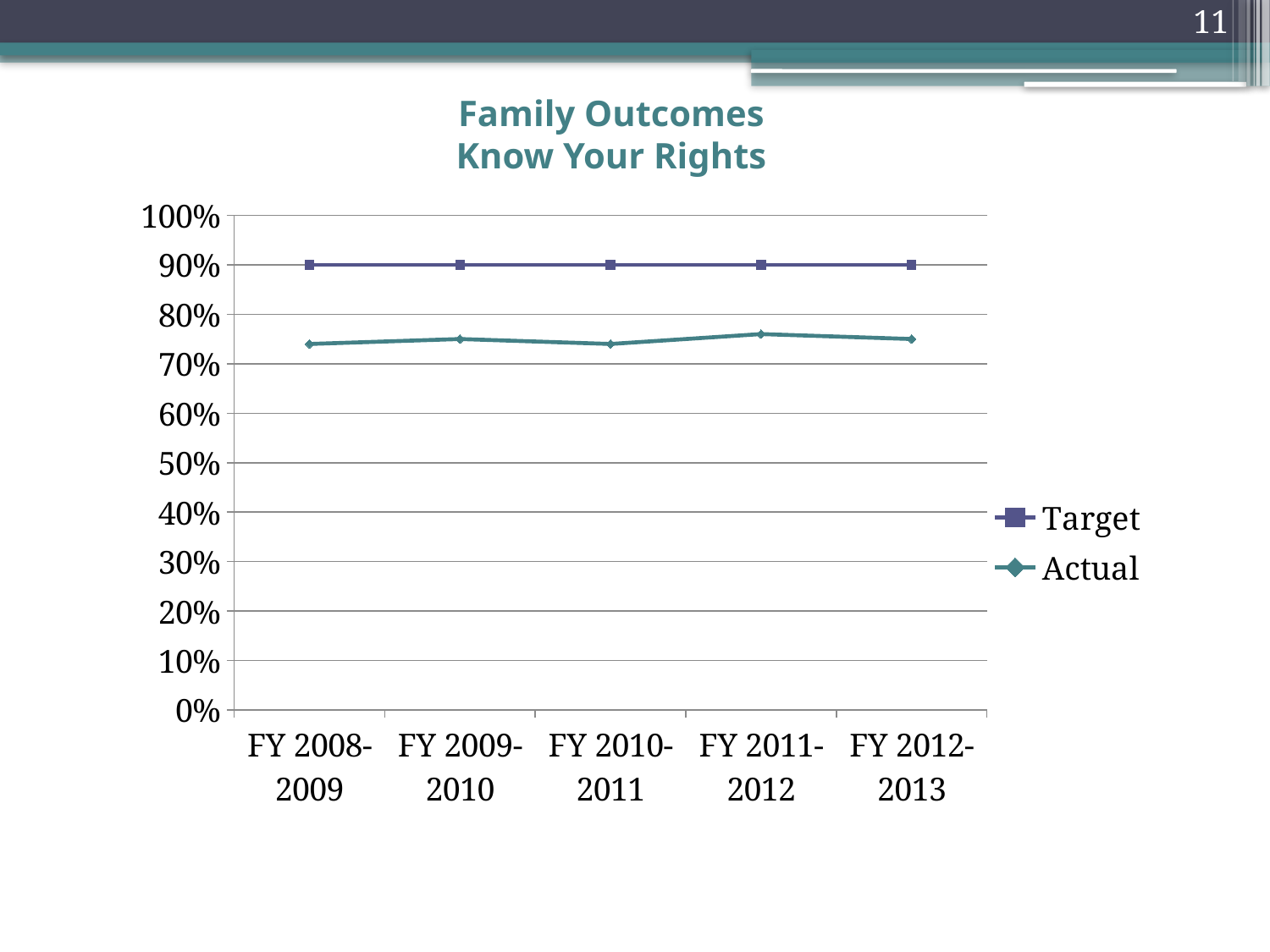
How many fiscal years are plotted along the x axis? 5 Which series is higher in FY 2010-2011, Target or Actual? Target What is the title of the chart? Family Outcomes Know Your Rights What kind of chart is shown on the slide? Line chart Is the Actual value for FY 2008-2009 greater or less than 80%? less How many series does the legend list? 2 Does the Target line rise, fall, or stay flat across the fiscal years? Stays flat What is the Target value for FY 2008-2009? 90% Which legend entry is shown with square markers? Target What is the Target value for FY 2012-2013? 90% Is the Actual value for FY 2011-2012 greater or less than 70%? greater Is the Actual value for FY 2012-2013 greater or less than 90%? less